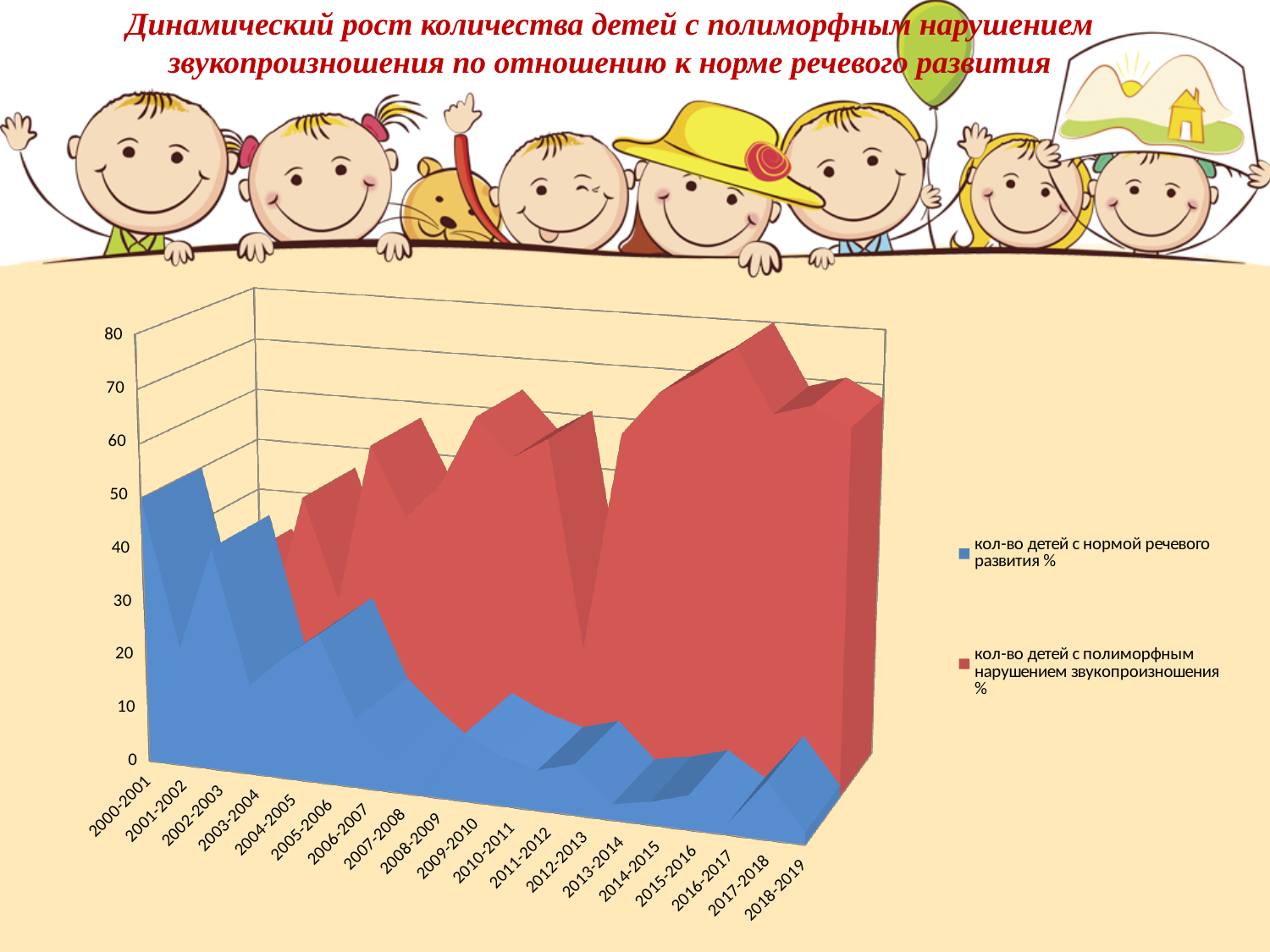
Which series is shown in red? кол-во детей с полиморфным нарушением звукопроизношения % In which school year is the value for 'кол-во детей с нормой речевого развития %' highest? 2000-2001 Is the value for 'кол-во детей с полиморфным нарушением звукопроизношения %' in 2016-2017 greater or less than 60? greater Does the series 'кол-во детей с нормой речевого развития %' generally rise or fall from 2000-2001 to 2018-2019? fall Is the value for 'кол-во детей с нормой речевого развития %' in 2018-2019 greater or less than 10? less In 2018-2019, which series has the larger value: 'кол-во детей с нормой речевого развития %' or 'кол-во детей с полиморфным нарушением звукопроизношения %'? кол-во детей с полиморфным нарушением звукопроизношения % Does the series 'кол-во детей с полиморфным нарушением звукопроизношения %' generally rise or fall from 2000-2001 to 2018-2019? rise What kind of chart is shown on the slide? area chart How many series does the legend list? 2 How many school-year categories are shown on the x axis? 19 Is the value for 'кол-во детей с нормой речевого развития %' in 2000-2001 greater or less than 40? greater Which series is shown in blue? кол-во детей с нормой речевого развития %